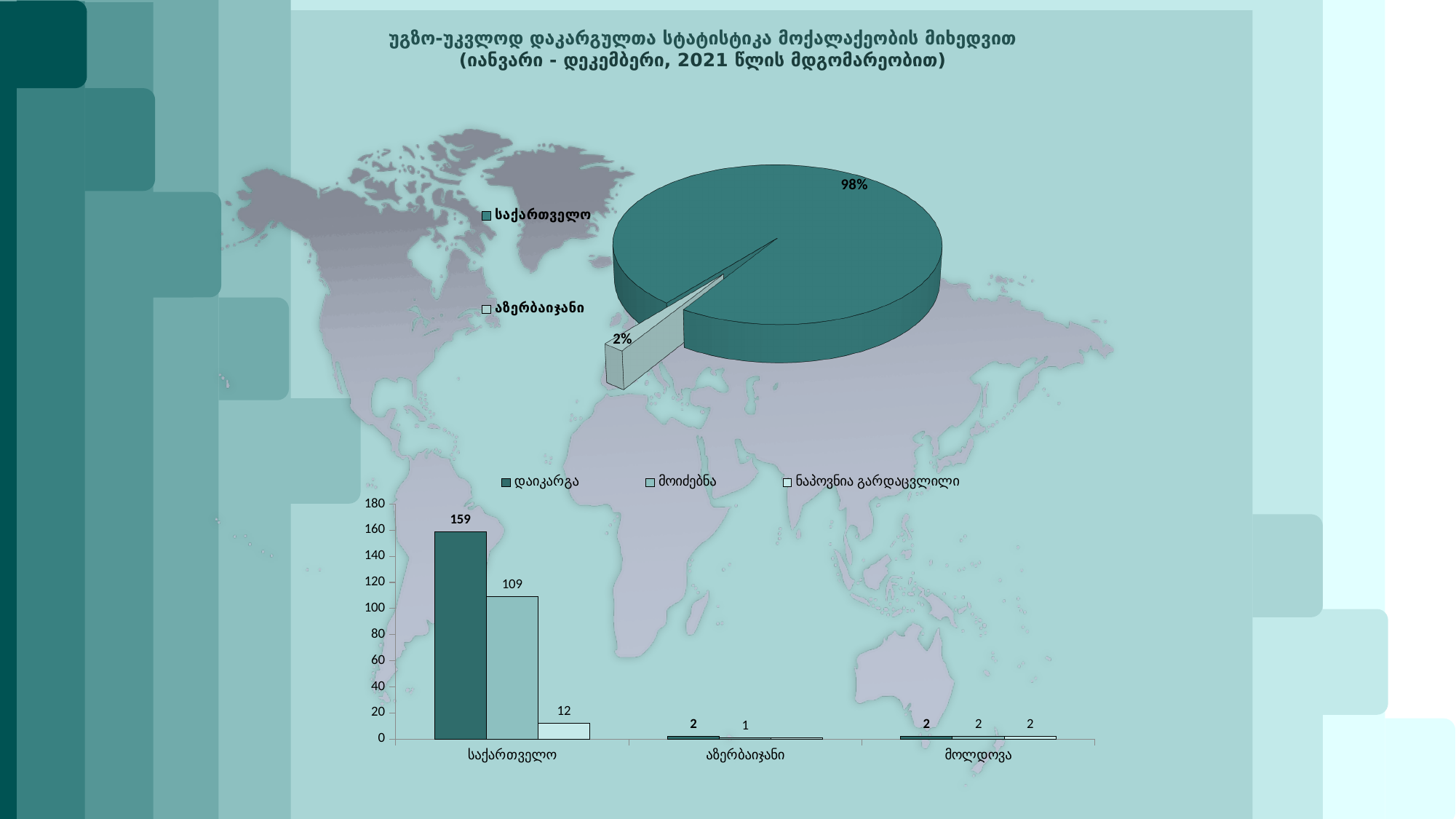
In the bar chart at the bottom of the slide, what is the value of ნაპოვნია გარდაცვლილი for საქართველო? 12 In the pie chart at the top of the slide, what share is shown for საქართველო? 98% In the bar chart at the bottom of the slide, what is the value of მოიძებნა for აზერბაიჯანი? 1 In the bar chart at the bottom of the slide, what is the difference between დაიკარგა and მოიძებნა for საქართველო? 50 How many categories are shown on the x axis of the bar chart at the bottom of the slide? 3 What kind of chart is the chart at the bottom of the slide? bar chart In the pie chart at the top of the slide, what share is shown for აზერბაიჯანი? 2% How many entries does the legend of the pie chart at the top of the slide list? 2 How many series does the legend of the bar chart at the bottom of the slide list? 3 In the bar chart at the bottom of the slide, what is the value of მოიძებნა for საქართველო? 109 In the bar chart at the bottom of the slide, what is the value of დაიკარგა for საქართველო? 159 In the bar chart at the bottom of the slide, which category has the highest დაიკარგა value? საქართველო